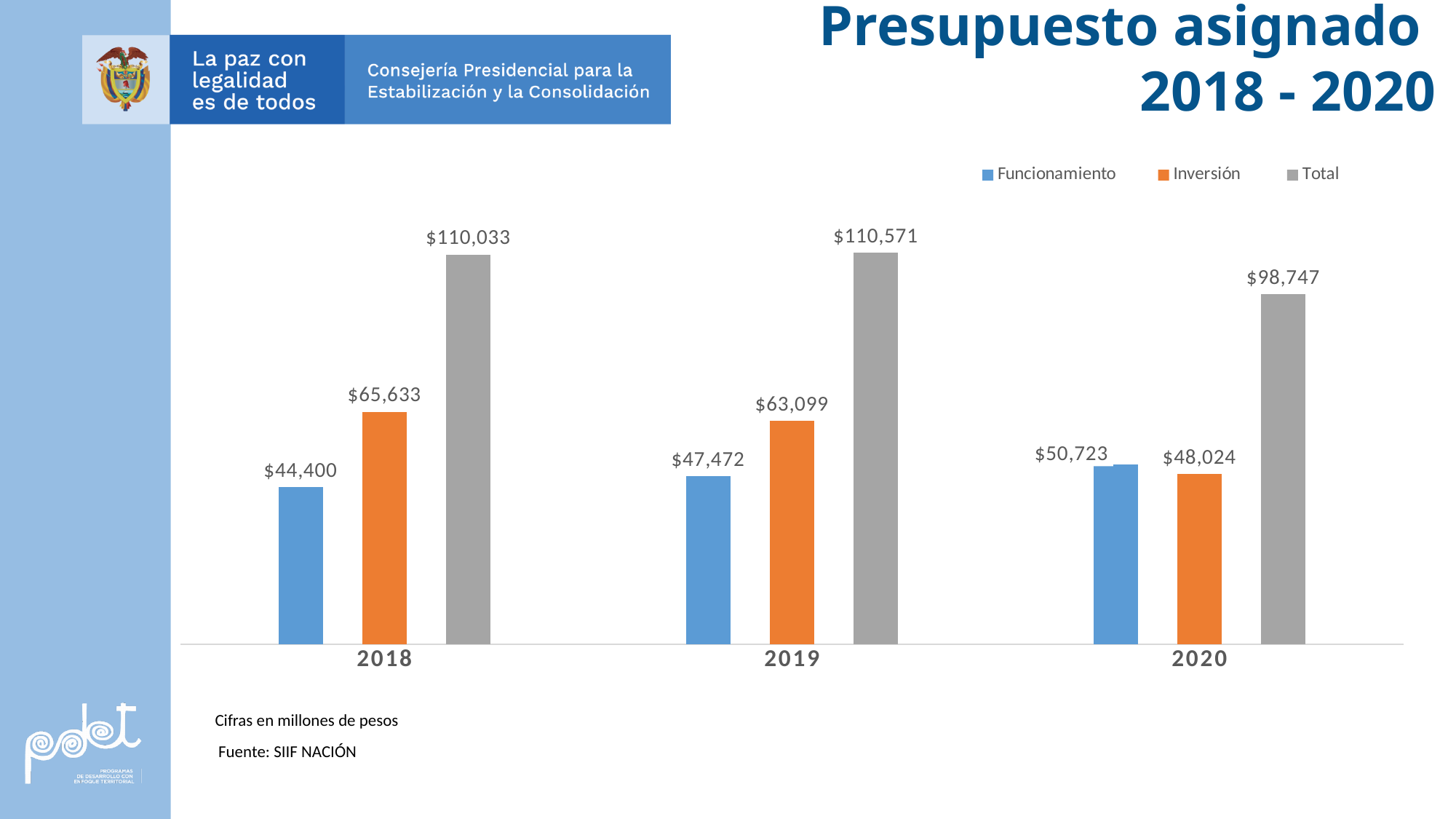
What is the difference between the Inversión values for 2018 and 2020? $17,609 What kind of chart is shown on the slide? Bar chart Which year has the lowest Funcionamiento value? 2018 Which is larger in 2020, Funcionamiento or Inversión? Funcionamiento Which year has the highest Total value? 2019 What colour represents the Total series in the legend? Grey What is the Inversión value for 2019? $63,099 What is the Total value for 2020? $98,747 How many series does the legend list? 3 Does the Inversión value rise or fall from 2018 to 2020? Fall What is the Funcionamiento value for 2018? $44,400 How many years are shown on the x axis? 3